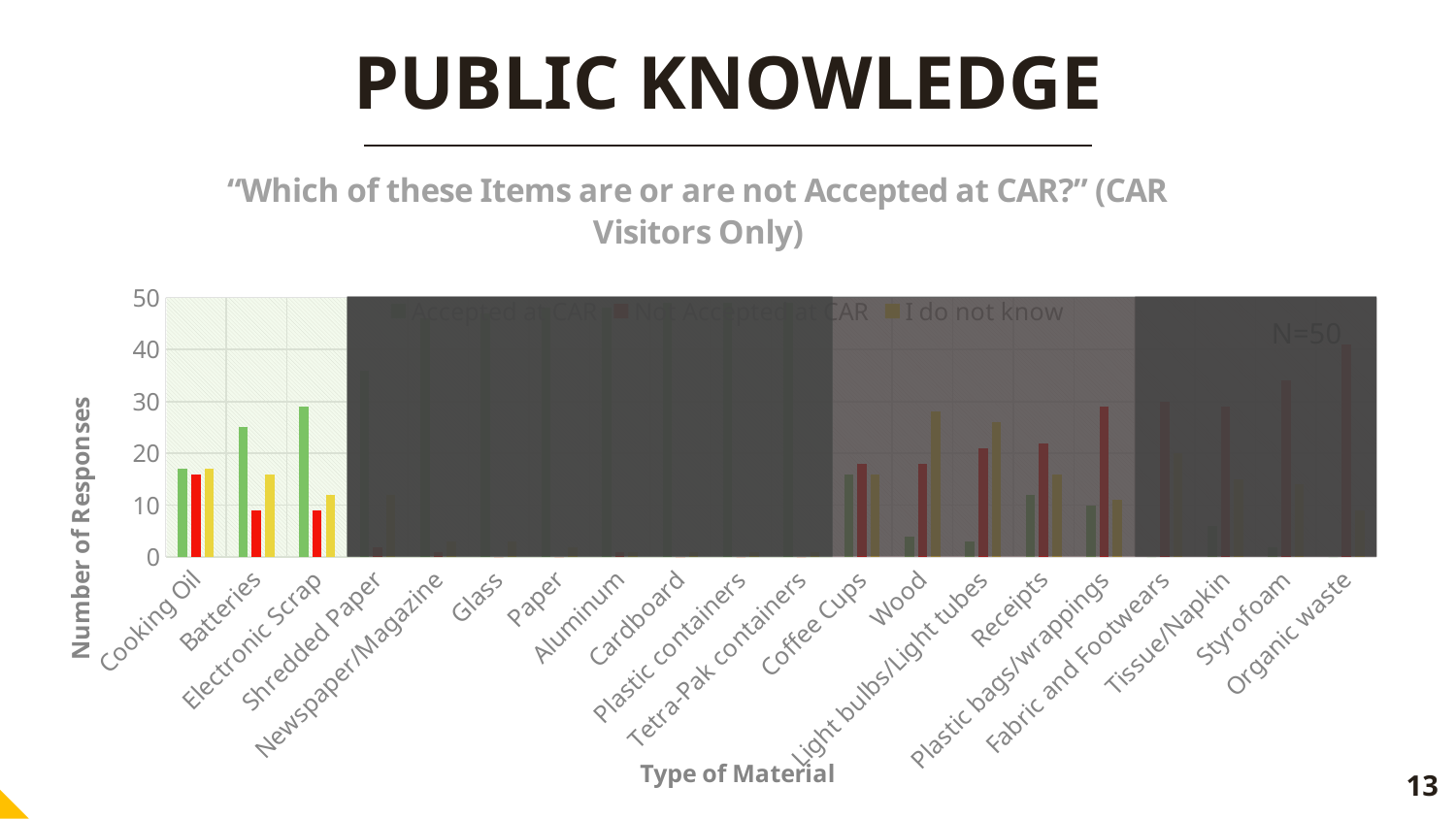
Which type of material has the highest 'Not Accepted at CAR' value? Organic waste Is the 'Accepted at CAR' value for Electronic Scrap greater or less than 20? greater How many types of material are shown on the x axis of the chart? 20 What type of chart is shown on the slide? Bar chart Is the 'I do not know' value for Wood greater or less than 20? greater What is the title of the y axis of the chart? Number of Responses Is the 'Not Accepted at CAR' value for Organic waste greater or less than 30? greater For Batteries, which is larger: the 'Accepted at CAR' value or the 'Not Accepted at CAR' value? Accepted at CAR What are the three series named in the chart legend? Accepted at CAR, Not Accepted at CAR, I do not know How many series does the chart legend list? 3